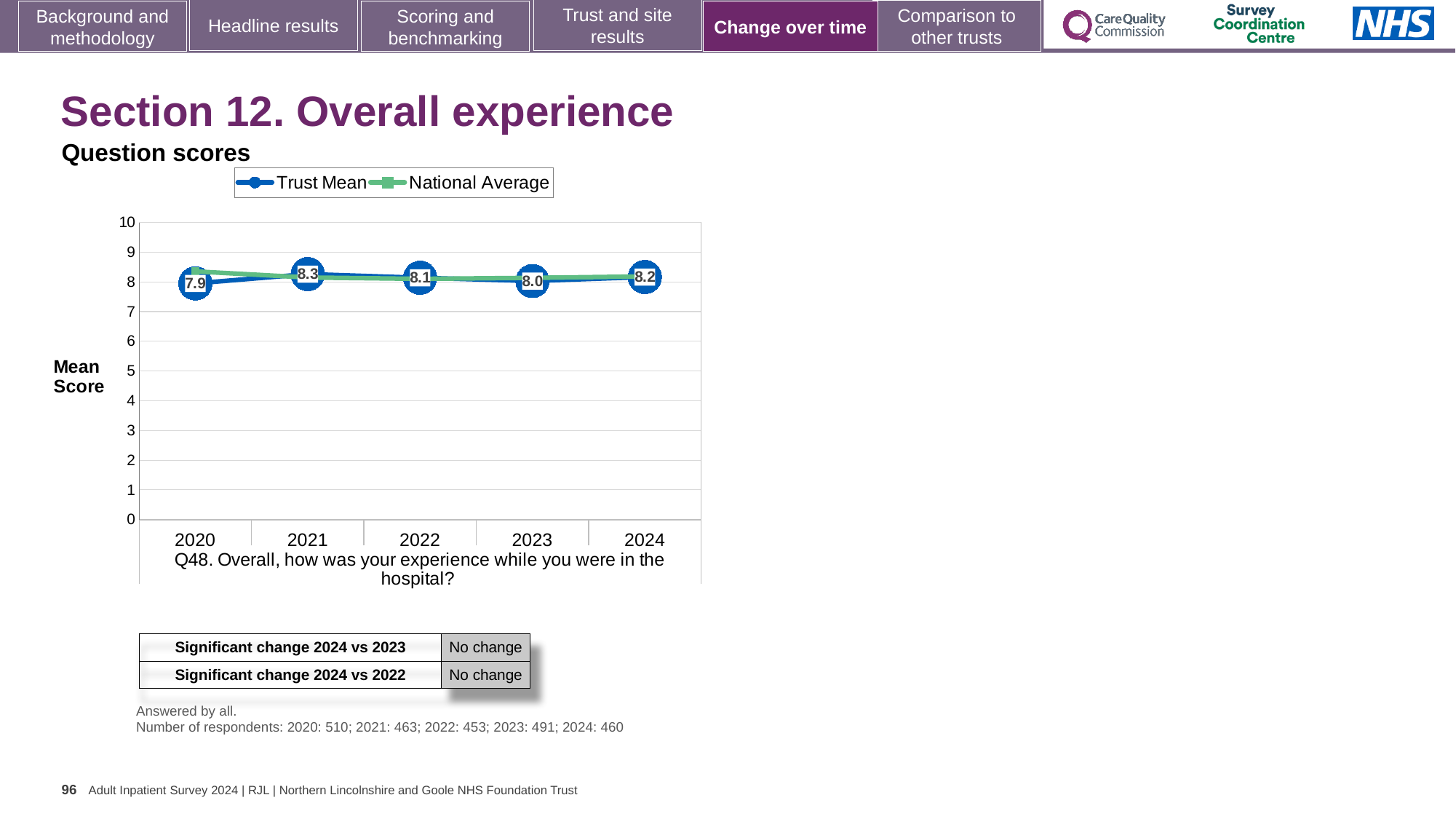
What is the Trust Mean value for 2020? 7.9 In which year is the Trust Mean highest? 2021 How many years are plotted on the x axis? 5 How many series does the legend list? 2 What is the Trust Mean value for 2024? 8.2 Which year has the larger Trust Mean, 2023 or 2024? 2024 What is the difference between the Trust Mean in 2021 and in 2020? 0.4 What kind of chart is shown on the slide? Line chart Does the Trust Mean rise or fall from 2020 to 2021? Rise Is the National Average value for 2020 greater or less than 5? greater What is the Trust Mean value for 2021? 8.3 In which year is the Trust Mean lowest? 2020